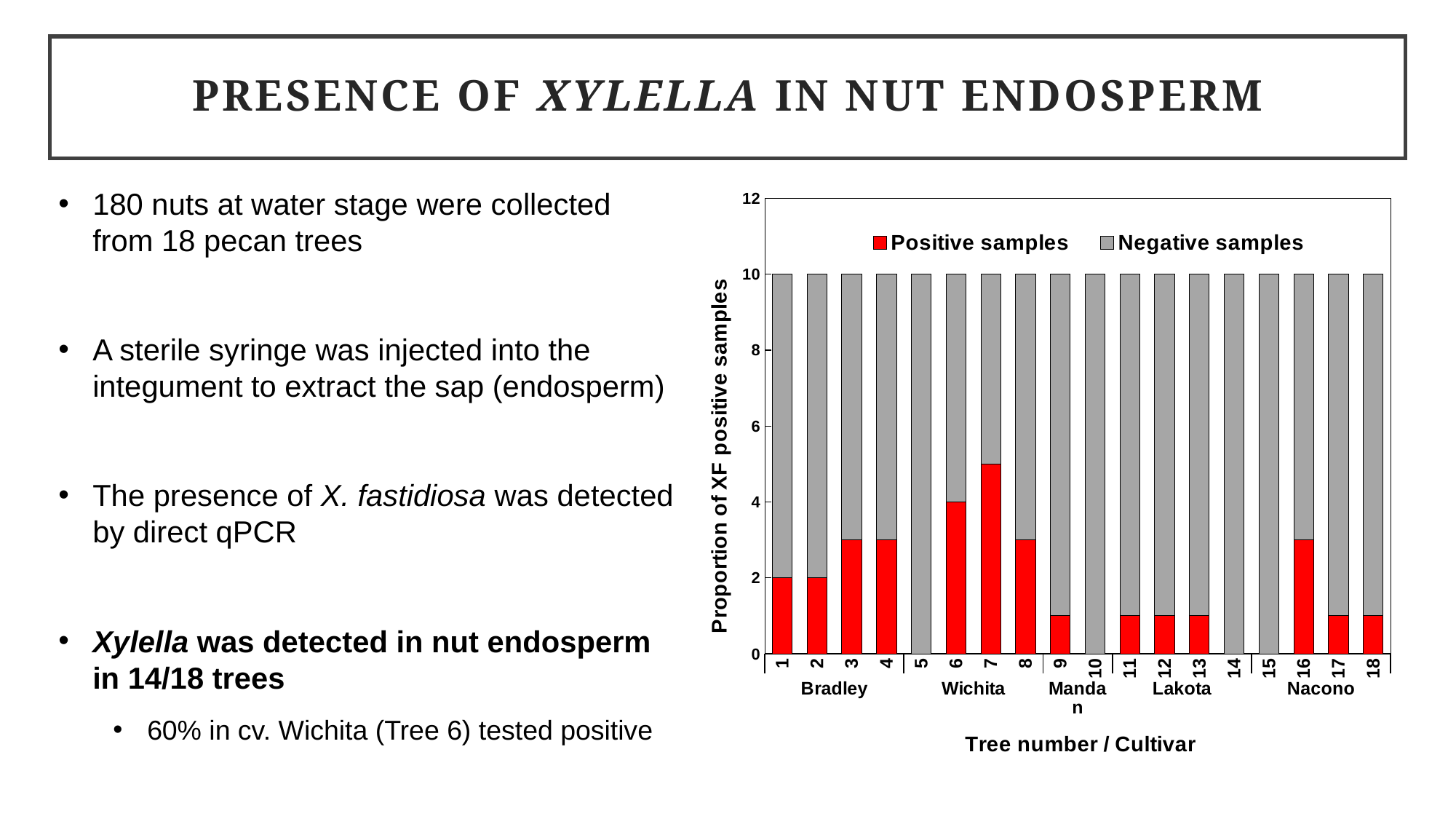
What is the total height of the stacked bar for tree 1? 10 How many series does the chart legend list? 2 How many trees (bars) are plotted on the x axis of the chart? 18 What is the value of Positive samples for tree 6? 4 What is the label of the y axis of the chart? Proportion of XF positive samples Is the value of Positive samples for tree 7 greater or less than 4? greater Which tree has the highest number of Positive samples? Tree 7 What is the value of Positive samples for tree 1? 2 What are the two series named in the chart legend? Positive samples and Negative samples Is the value of Positive samples for tree 16 greater or less than 4? less What kind of chart is shown on the slide? Stacked bar chart Which has more Positive samples, tree 6 or tree 9? Tree 6